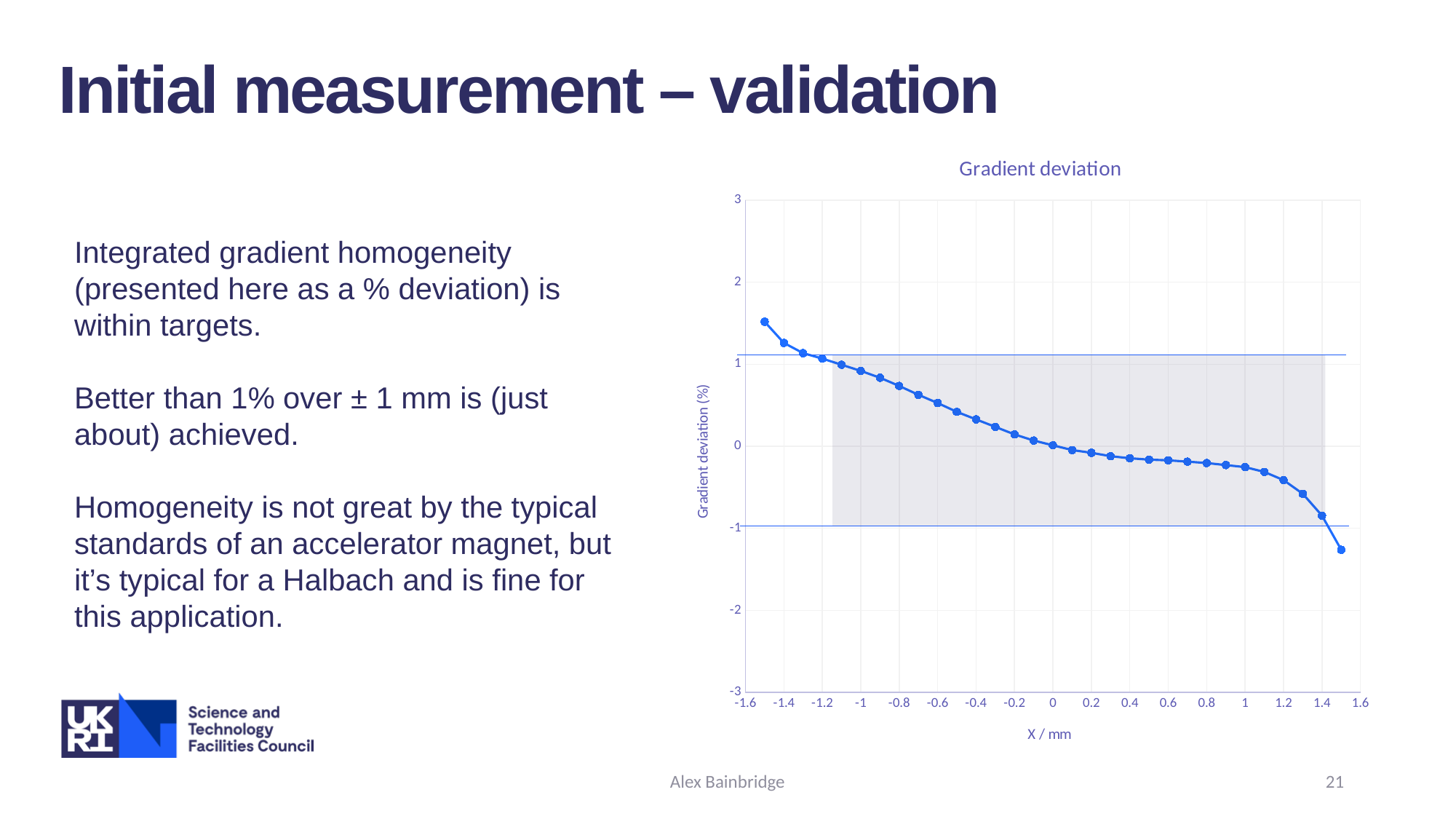
Is the gradient deviation at X = 1.5 greater or less than -1? less Do the plotted values rise or fall as X increases along the x axis? fall Is the gradient deviation at X = -1.5 greater or less than 1? greater Is the gradient deviation at X = 1 greater or less than 0? less How many data points are plotted on the chart? 31 At which X value is the gradient deviation highest? -1.5 At which X value is the gradient deviation lowest? 1.5 What is the label of the x axis of the chart? X / mm What type of chart is shown on the slide? line chart Which has the larger gradient deviation, X = -1.5 or X = 1.5? X = -1.5 What is the title of the chart? Gradient deviation